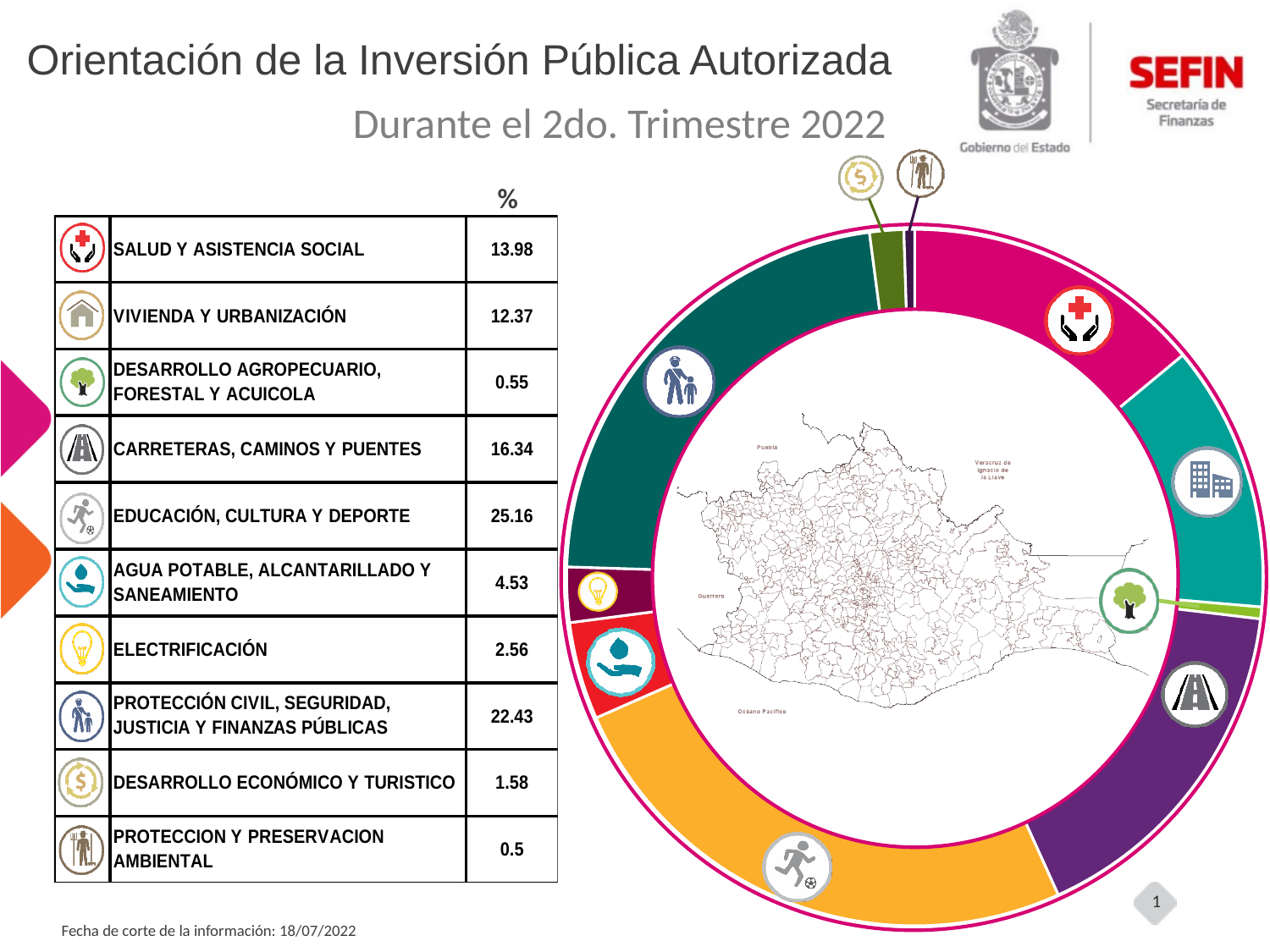
What is the title of the slide containing the chart? Orientación de la Inversión Pública Autorizada Durante el 2do. Trimestre 2022 How many categories does the chart show? 10 What is the difference in percentage points between EDUCACIÓN, CULTURA Y DEPORTE and PROTECCIÓN CIVIL, SEGURIDAD, JUSTICIA Y FINANZAS PÚBLICAS? 2.73 What is the percentage for CARRETERAS, CAMINOS Y PUENTES? 16.34 What is the percentage for DESARROLLO ECONÓMICO Y TURISTICO? 1.58 What is the difference in percentage points between CARRETERAS, CAMINOS Y PUENTES and SALUD Y ASISTENCIA SOCIAL? 2.36 Which category has the lowest percentage? PROTECCION Y PRESERVACION AMBIENTAL Which has a larger percentage, VIVIENDA Y URBANIZACIÓN or ELECTRIFICACIÓN? VIVIENDA Y URBANIZACIÓN What kind of chart is shown on the slide? Doughnut chart What is the percentage for AGUA POTABLE, ALCANTARILLADO Y SANEAMIENTO? 4.53 Which category has the highest percentage? EDUCACIÓN, CULTURA Y DEPORTE What is the percentage for EDUCACIÓN, CULTURA Y DEPORTE? 25.16